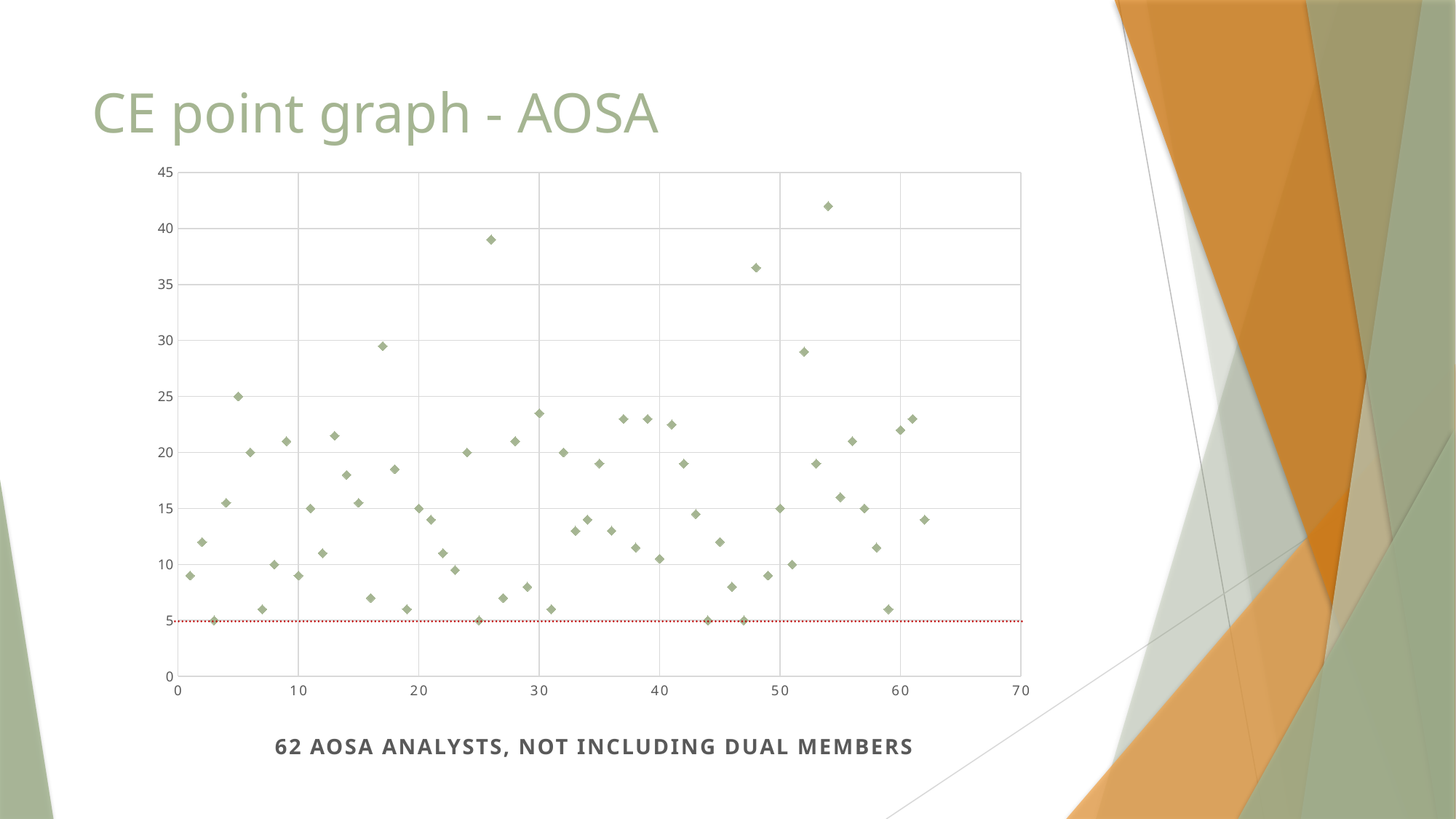
What is the highest tick value shown on the y axis? 45 How many plotted points sit on the red dotted line at 5? 4 Is the point plotted near x = 17 greater or less than 25? greater Is the lowest plotted point greater or less than 10? less How many plotted points lie above 35 on the y axis? 3 Is the point plotted near x = 26 greater or less than 35? greater What kind of chart is shown on the slide? scatter chart At what y-axis value is the red dotted horizontal line drawn? 5 What is the title of the chart on the slide? CE point graph - AOSA According to the caption below the chart, how many AOSA analysts are plotted? 62